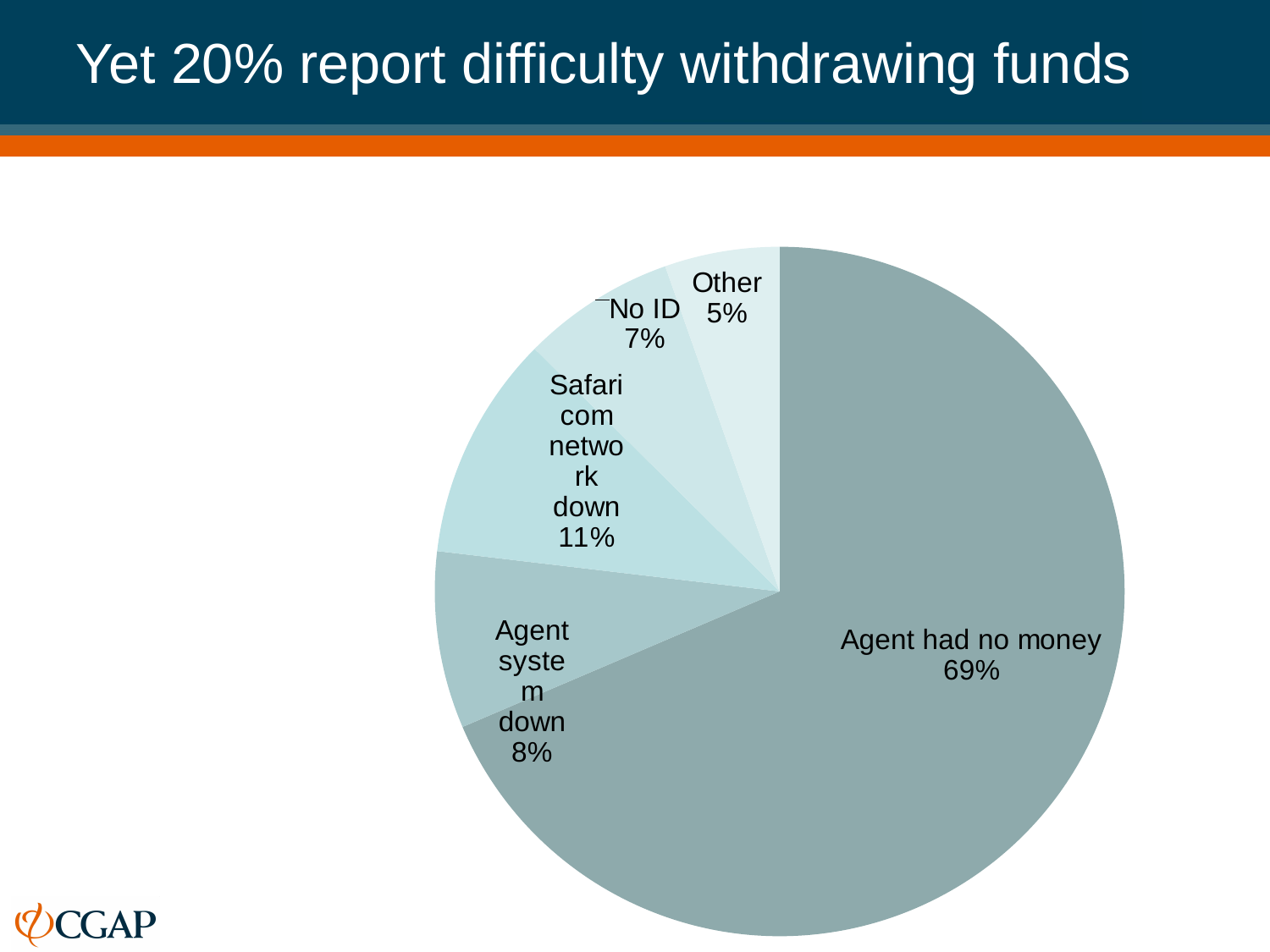
What percentage is shown for "Agent system down"? 8% What kind of chart is shown on the slide? Pie chart What is the difference in percentage points between "Agent had no money" and "Safaricom network down"? 58 What percentage is shown for "Other"? 5% Which slice of the pie is the largest? Agent had no money What share of the pie is labelled "Agent had no money"? 69% What percentage is shown for "Safaricom network down"? 11% What is the title of the slide containing the pie chart? Yet 20% report difficulty withdrawing funds How many slices does the pie chart have? 5 Which slice of the pie is the smallest? Other Which is larger, the share for "Agent system down" or the share for "No ID"? Agent system down What percentage is shown for "No ID"? 7%